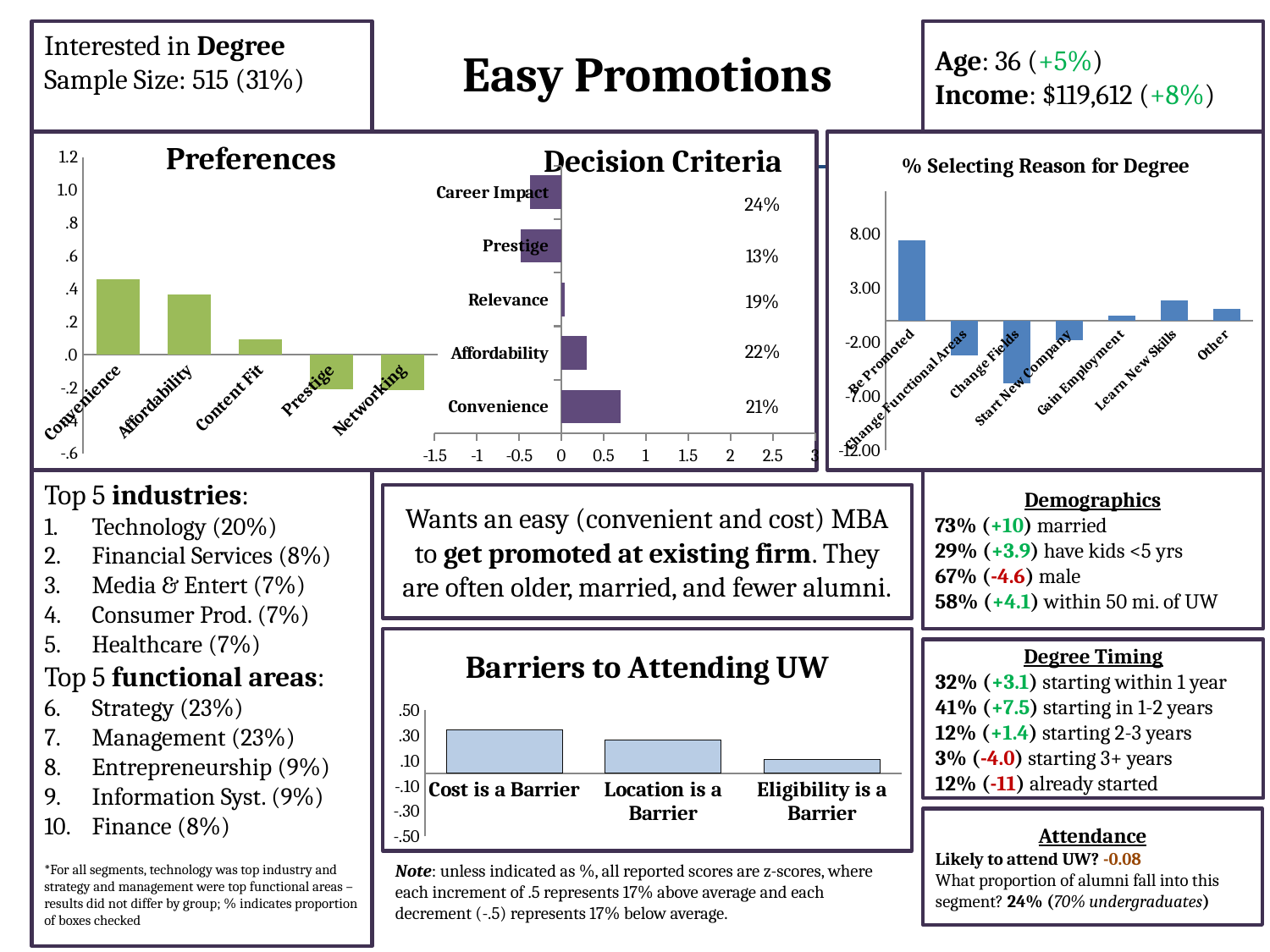
In the Decision Criteria chart, what percentage is shown for Career Impact? 24% In the Decision Criteria chart, which category has the longest bar? Convenience In the Preferences chart, is the value for Affordability greater or less than .2? greater In the % Selecting Reason for Degree chart, which category has the highest value? Be Promoted How many categories are shown in the Preferences chart? 5 In the Preferences chart, is the value for Prestige greater or less than .0? less In the % Selecting Reason for Degree chart, which category has the lowest value? Change Fields In the Preferences chart, which category has the highest value? Convenience In the Decision Criteria chart, is the bar for Convenience greater or less than 0.5? greater In the Barriers to Attending UW chart, which category has the lowest value? Eligibility is a Barrier What type of chart is the Barriers to Attending UW chart? bar chart In the Decision Criteria chart, what percentage is shown for Prestige? 13%